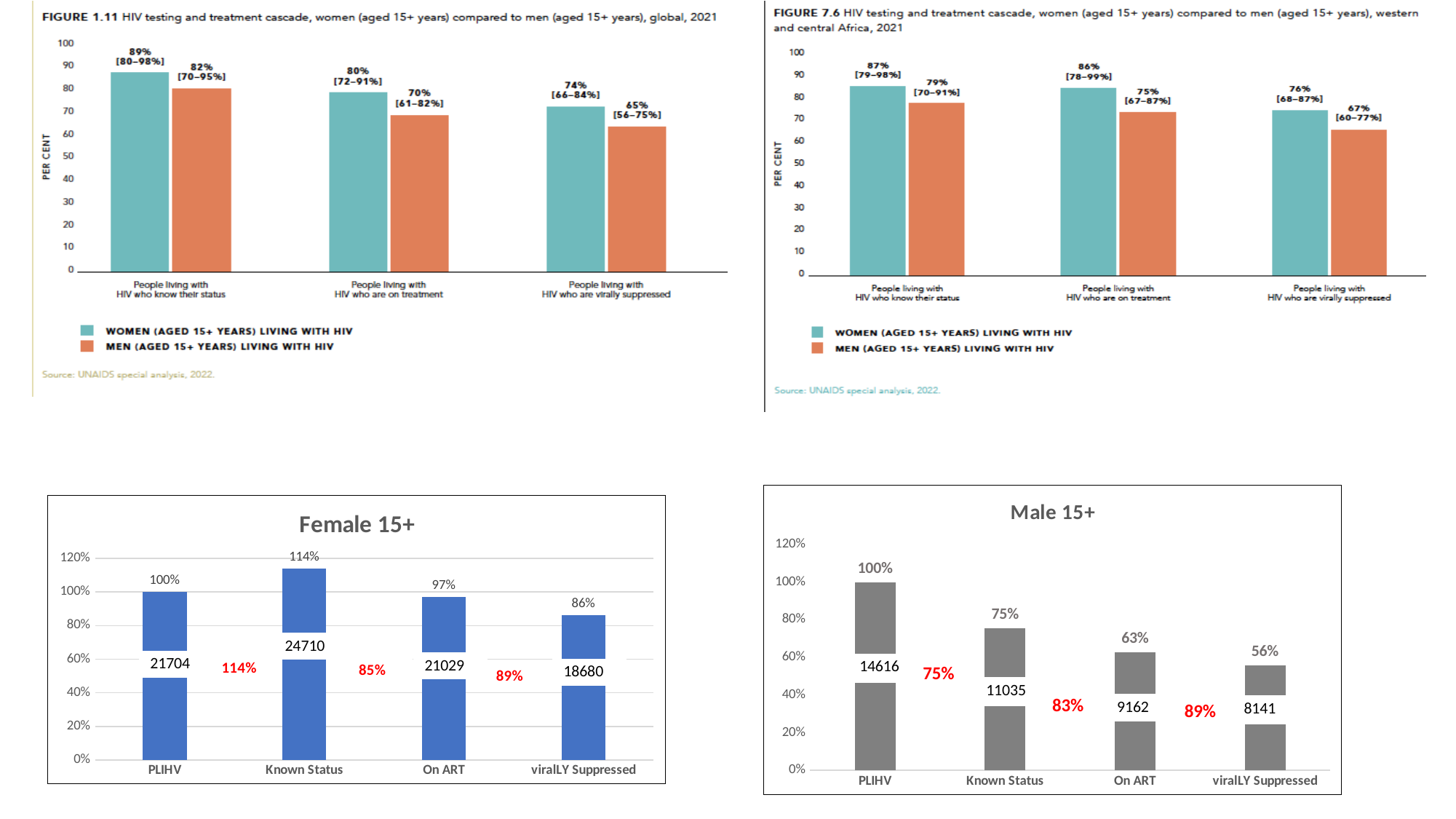
What type of chart is the bottom-right chart titled 'Male 15+'? Bar chart In the bottom-left chart titled 'Female 15+', what percentage is shown for virally Suppressed? 86% In the top-left chart (Figure 1.11, global, 2021), what percentage of men aged 15+ living with HIV are virally suppressed? 65% In the bottom-right chart titled 'Male 15+', what is the number shown for On ART? 9162 In the bottom-right chart titled 'Male 15+', which category has the lowest percentage? viralLY Suppressed In the top-right chart (Figure 7.6, western and central Africa, 2021), which group has the higher value for people living with HIV who know their status, women or men? Women In the top-right chart (Figure 7.6, western and central Africa, 2021), what percentage of women aged 15+ living with HIV are on treatment? 86% In the top-left chart (Figure 1.11, global, 2021), what percentage of women aged 15+ living with HIV know their status? 89% In the top-left chart (Figure 1.11, global, 2021), what is the difference between women and men for people living with HIV who are on treatment? 10 percentage points In the bottom-left chart titled 'Female 15+', what is the number shown for Known Status? 24710 How many series does the legend of the top-right chart (Figure 7.6) list? 2 In the bottom-left chart titled 'Female 15+', which category has the highest percentage? Known Status